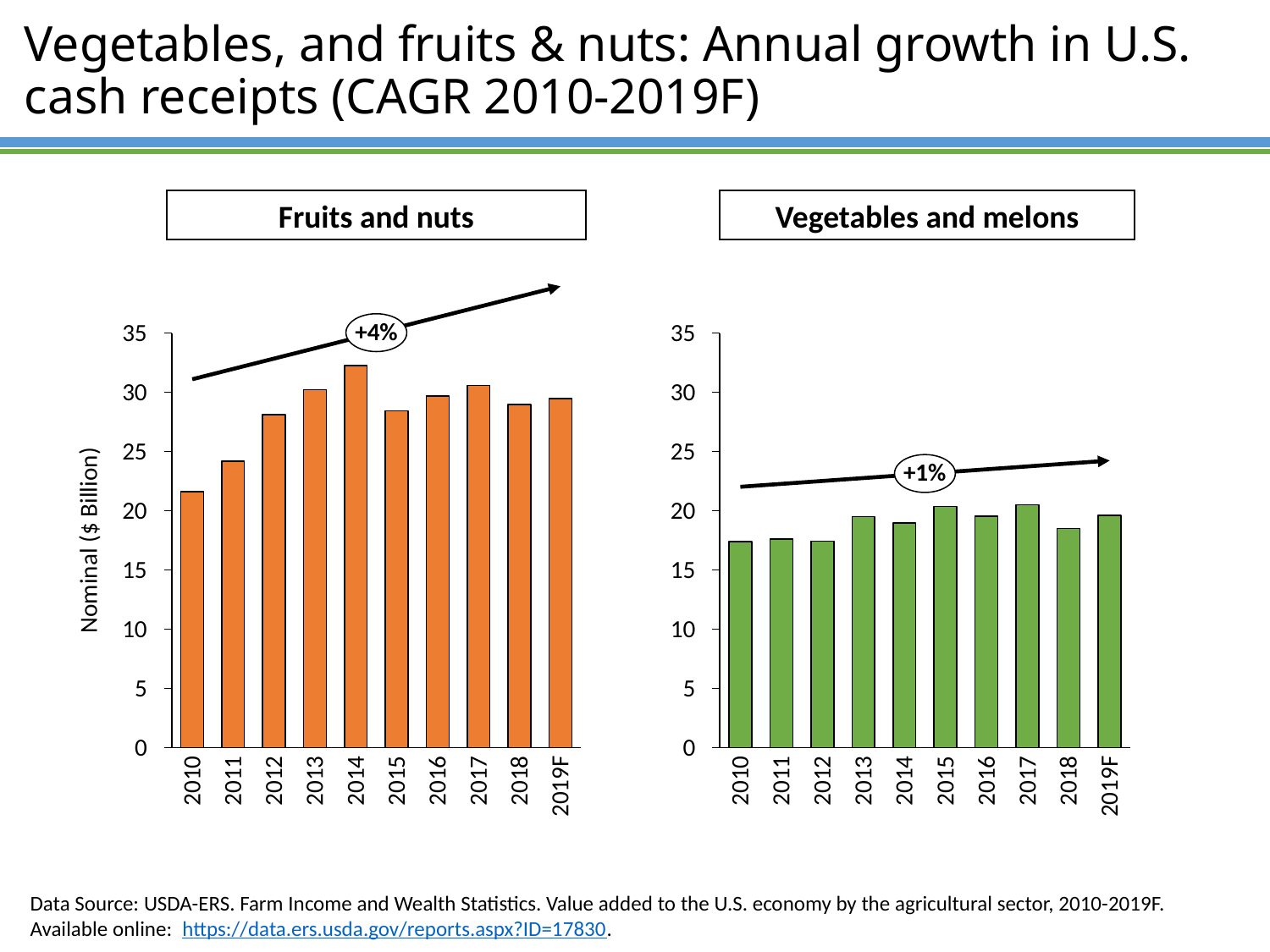
What annual growth rate (CAGR) is labelled on the Vegetables and melons chart? +1% In the Fruits and nuts chart, which year has the lowest cash receipts? 2010 In the Vegetables and melons chart, which is larger, the value for 2010 or the value for 2013? 2013 In the Vegetables and melons chart, is the value for 2018 greater or less than 20? less In the Vegetables and melons chart, is the value for 2010 greater or less than 20? less How many years are shown on the x axis of the Vegetables and melons chart? 10 In the Fruits and nuts chart, which is larger, the value for 2010 or the value for 2014? 2014 What annual growth rate (CAGR) is labelled on the Fruits and nuts chart? +4% In the Fruits and nuts chart, which year has the highest cash receipts? 2014 What type of chart is used for the Fruits and nuts data? bar chart In the Fruits and nuts chart, is the value for 2010 greater or less than 25? less